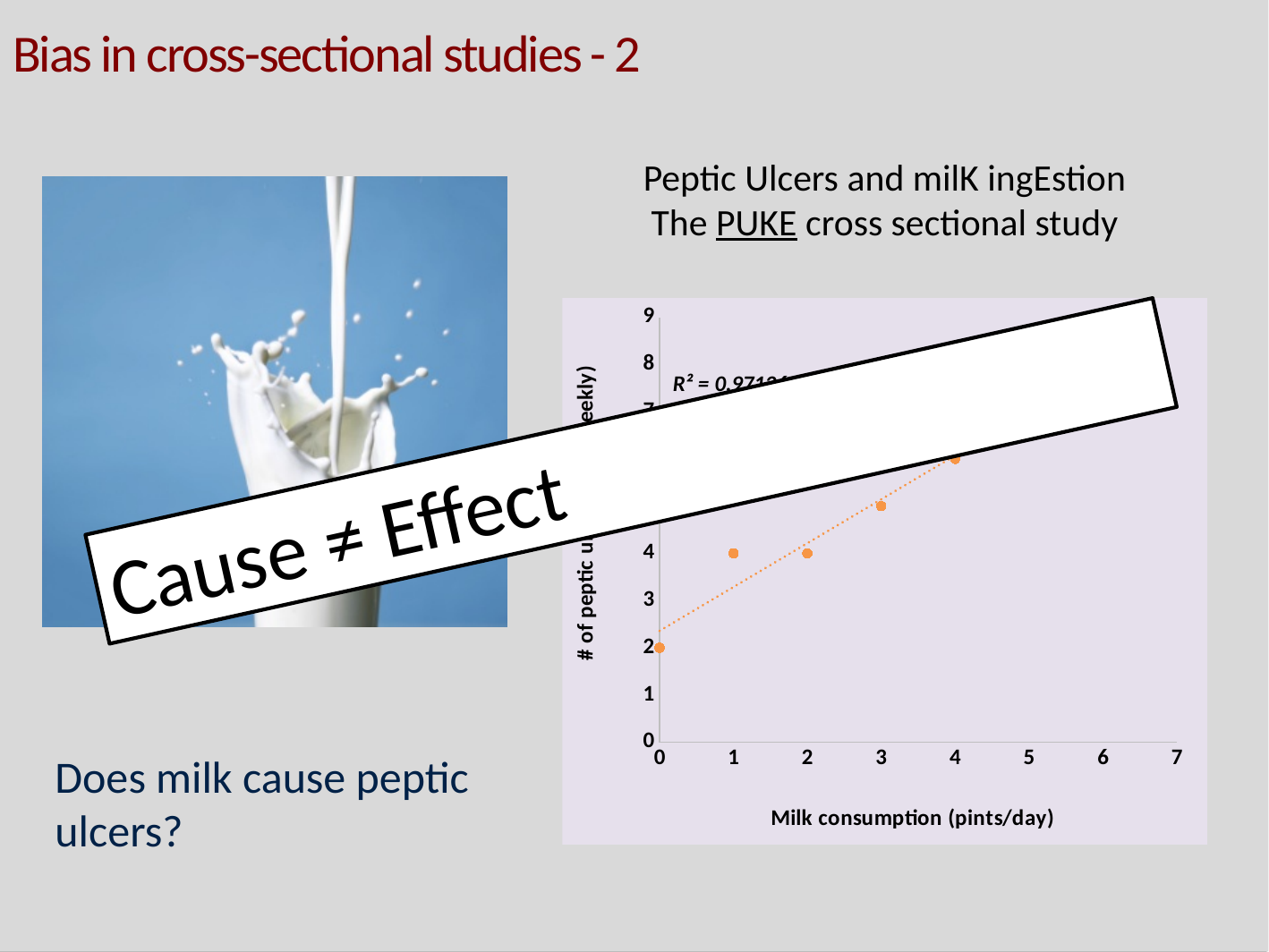
What is the number of peptic ulcers at a milk consumption of 1 pint/day? 4 Is the value at 0 pints/day greater or less than 3? less Is the value at 4 pints/day greater or less than 4? greater What is the x-axis title of the chart? Milk consumption (pints/day) What is the number of peptic ulcers at a milk consumption of 2 pints/day? 4 What is the difference between the values at 1 pint/day and 0 pints/day? 2 What kind of chart is shown on the slide? scatter chart Which is larger, the value at 0 pints/day or the value at 1 pint/day? 1 pint/day What is the number of peptic ulcers at a milk consumption of 0 pints/day? 2 Is the value at 3 pints/day greater or less than 4? greater Do the values rise or fall as milk consumption increases? rise Which milk consumption level has the lowest number of peptic ulcers? 0 pints/day